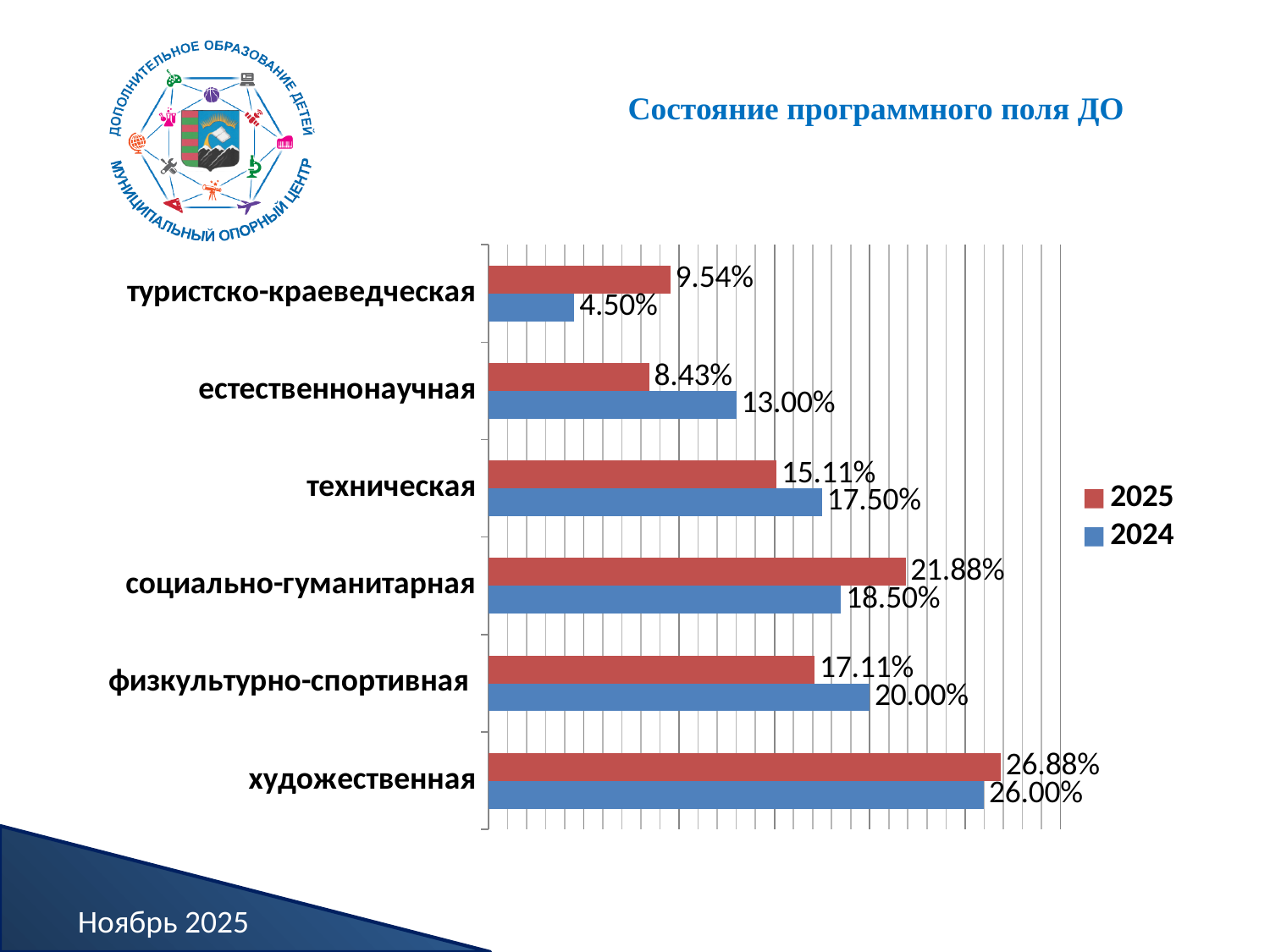
What is the 2024 value for туристско-краеведческая? 4.50% What is the 2024 value for естественнонаучная? 13.00% What kind of chart is shown on the slide? bar chart For техническая, which year has the larger value, 2024 or 2025? 2024 How many series does the legend list? 2 What is the 2025 value for художественная? 26.88% Which category has the lowest 2024 value? туристско-краеведческая Which category has the highest 2025 value? художественная What is the 2025 value for социально-гуманитарная? 21.88% How many categories are shown on the chart? 6 What colour represents the 2025 series in the legend? red What is the difference between the 2024 and 2025 values for физкультурно-спортивная? 2.89%